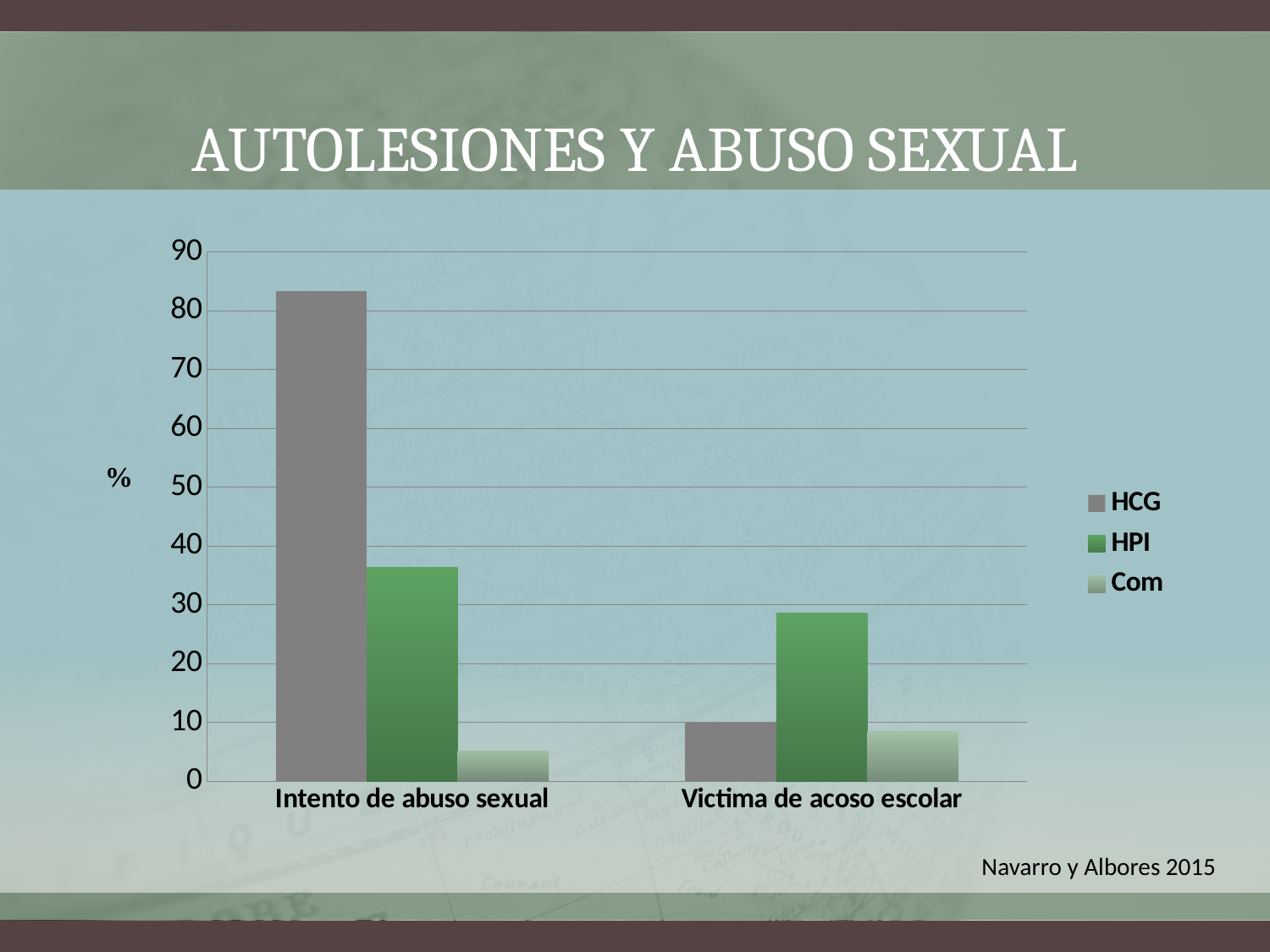
Which series has the lowest value for Intento de abuso sexual? Com Which series has the highest value for Victima de acoso escolar? HPI Is the HPI value for Intento de abuso sexual greater or less than 40? less How many series does the legend list? 3 How many categories are shown on the x axis? 2 Which is larger: the HCG value for Intento de abuso sexual or the HCG value for Victima de acoso escolar? Intento de abuso sexual What is the title of the slide containing the chart? AUTOLESIONES Y ABUSO SEXUAL Is the HCG value for Intento de abuso sexual greater or less than 80? greater What kind of chart is shown on the slide? bar chart Is the Com value for Intento de abuso sexual greater or less than 10? less Which series has the highest value for Intento de abuso sexual? HCG